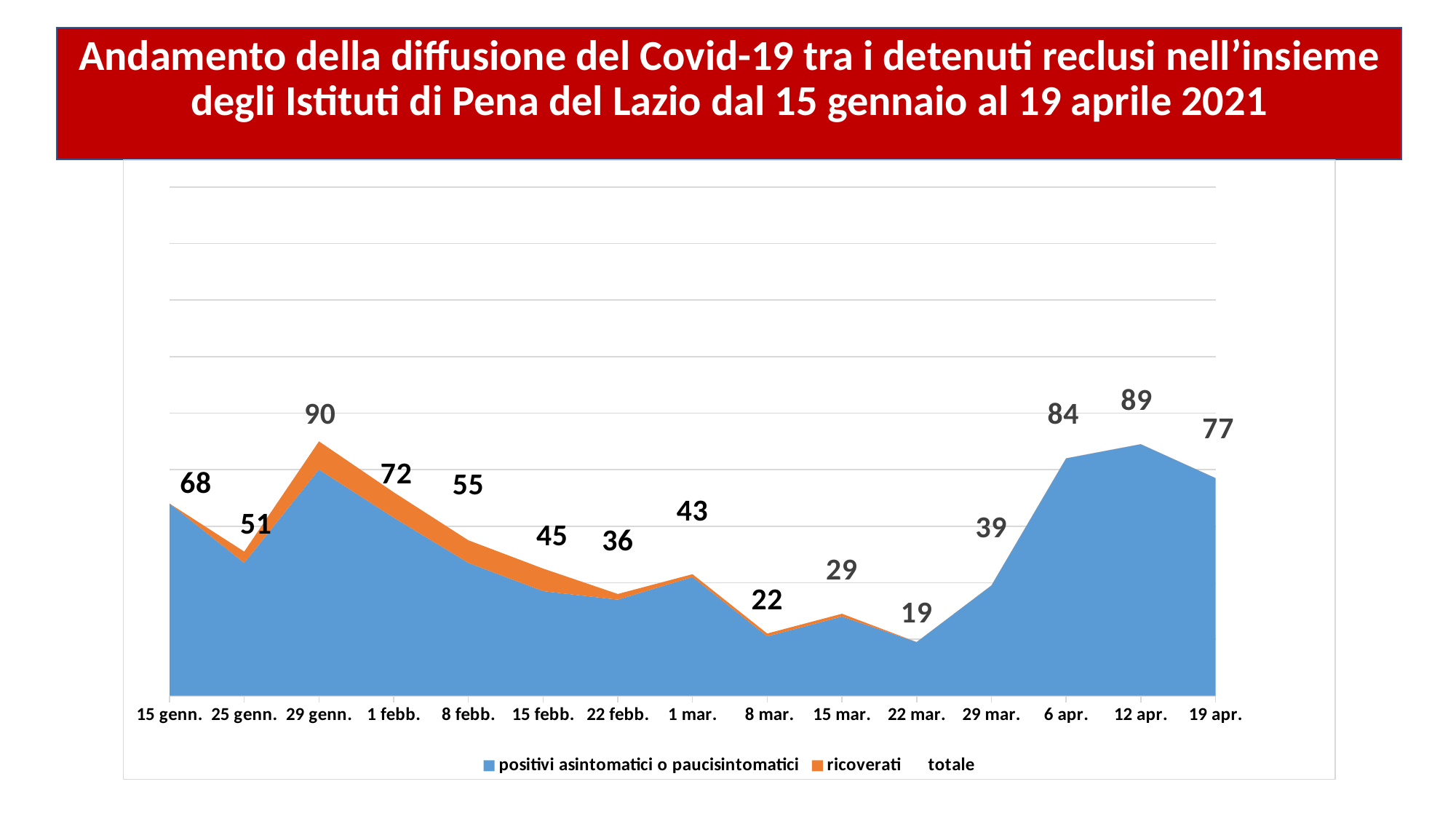
What is the total (totale) value shown for 15 genn.? 68 What is the total (totale) value shown for 22 mar.? 19 How many dates are shown on the x axis? 15 What is the total (totale) value shown for 29 genn.? 90 Which date has a larger total value, 1 febb. or 8 febb.? 1 febb. On which date is the total (totale) value highest? 29 genn. What is the total (totale) value shown for 12 apr.? 89 On which date is the total (totale) value lowest? 22 mar. What kind of chart is shown on the slide? Area chart Do the total values rise or fall from 22 mar. to 12 apr.? Rise How many series does the legend list? 3 What is the difference between the total values for 12 apr. and 19 apr.? 12